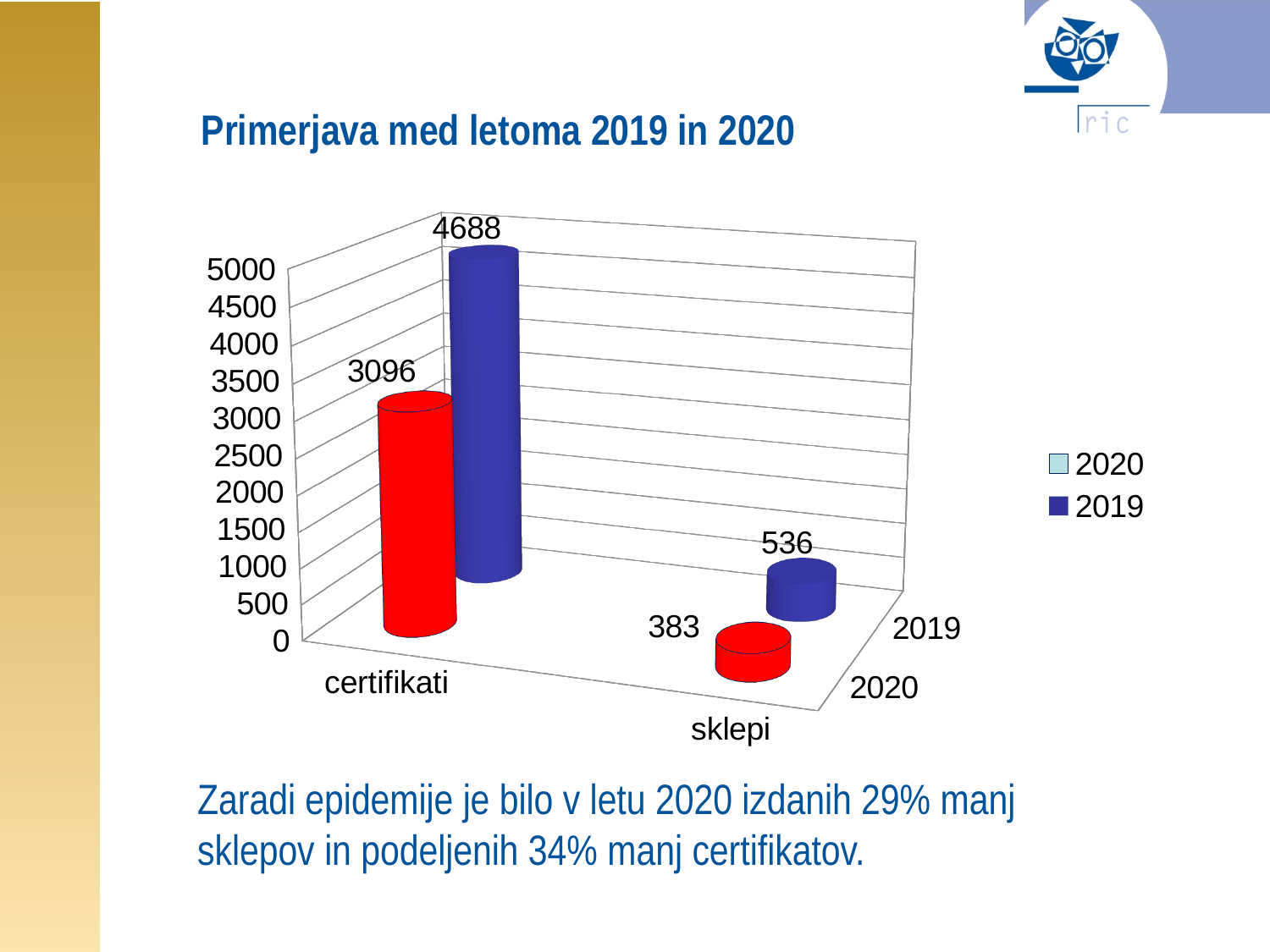
What is the value for certifikati in 2020? 3096 What is the value for certifikati in 2019? 4688 How many series does the legend list? 2 Which bar has the highest value on the chart? certifikati, 2019 What is the value for sklepi in 2020? 383 What is the value for sklepi in 2019? 536 What is the difference between the 2019 and 2020 values for certifikati? 1592 Which bar has the lowest value on the chart? sklepi, 2020 What kind of chart is shown on the slide? bar chart Which is larger for sklepi, the 2019 value or the 2020 value? 2019 How many categories are shown on the x axis? 2 What is the difference between the 2019 and 2020 values for sklepi? 153